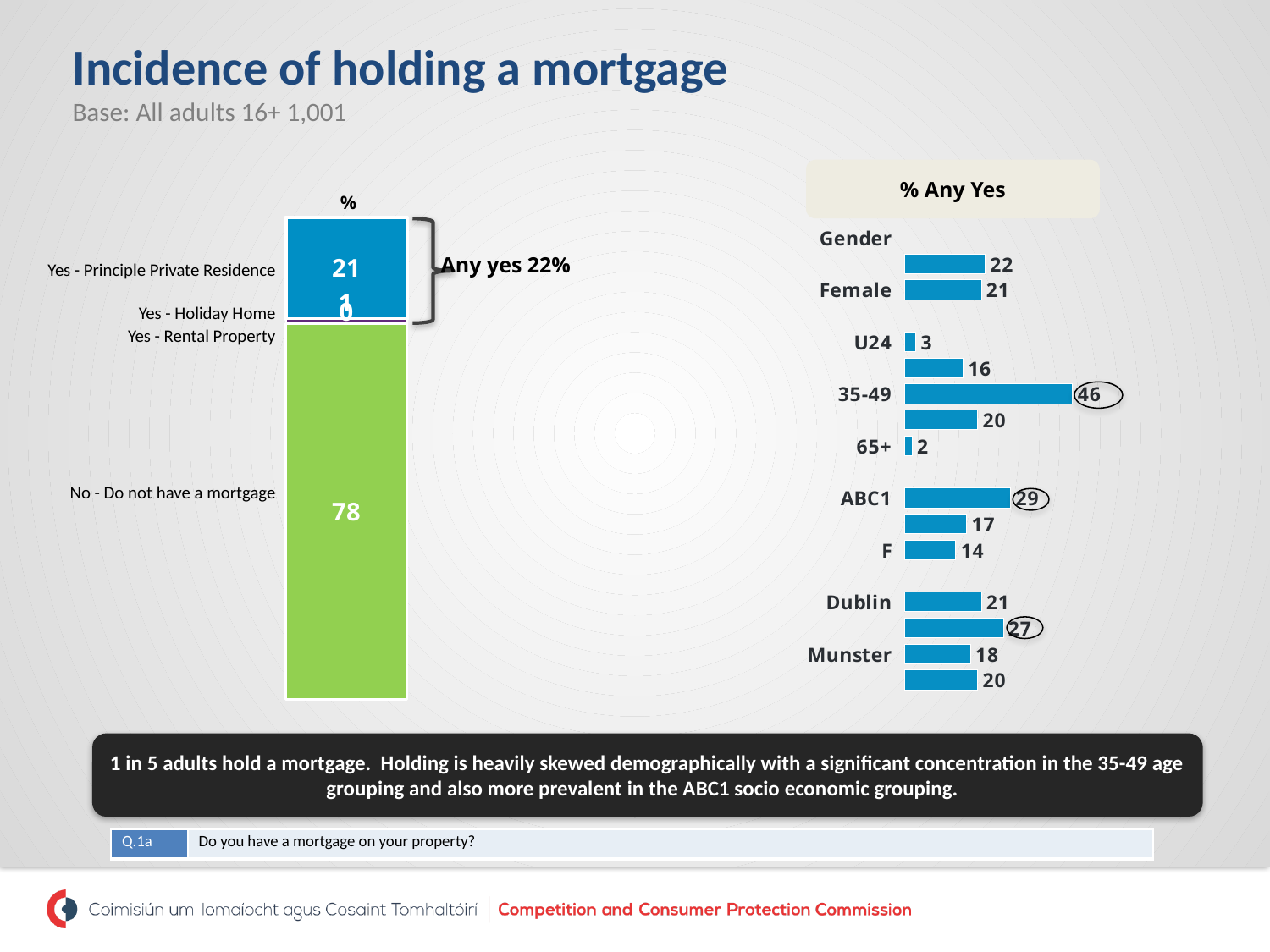
In the '% Any Yes' chart, which labelled category has the highest value? 35-49 In the '% Any Yes' chart, what is the difference between the values for ABC1 and F? 15 In the '% Any Yes' chart, what is the value for Female? 21 In the '% Any Yes' chart, what is the value for Munster? 18 In the '% Any Yes' chart, what is the value for ABC1? 29 In the '% Any Yes' chart, which is larger, the value for Dublin or the value for Munster? Dublin In the stacked bar chart on the left, what is the value for 'Yes - Principle Private Residence'? 21 What type of chart is shown on the right side of the slide under '% Any Yes'? Bar chart In the '% Any Yes' chart, what is the difference between the values for 35-49 and U24? 43 In the stacked bar chart on the left, what is the value for 'No - Do not have a mortgage'? 78 In the '% Any Yes' chart, what is the value for the 35-49 age group? 46 In the '% Any Yes' chart, which labelled category has the lowest value? 65+